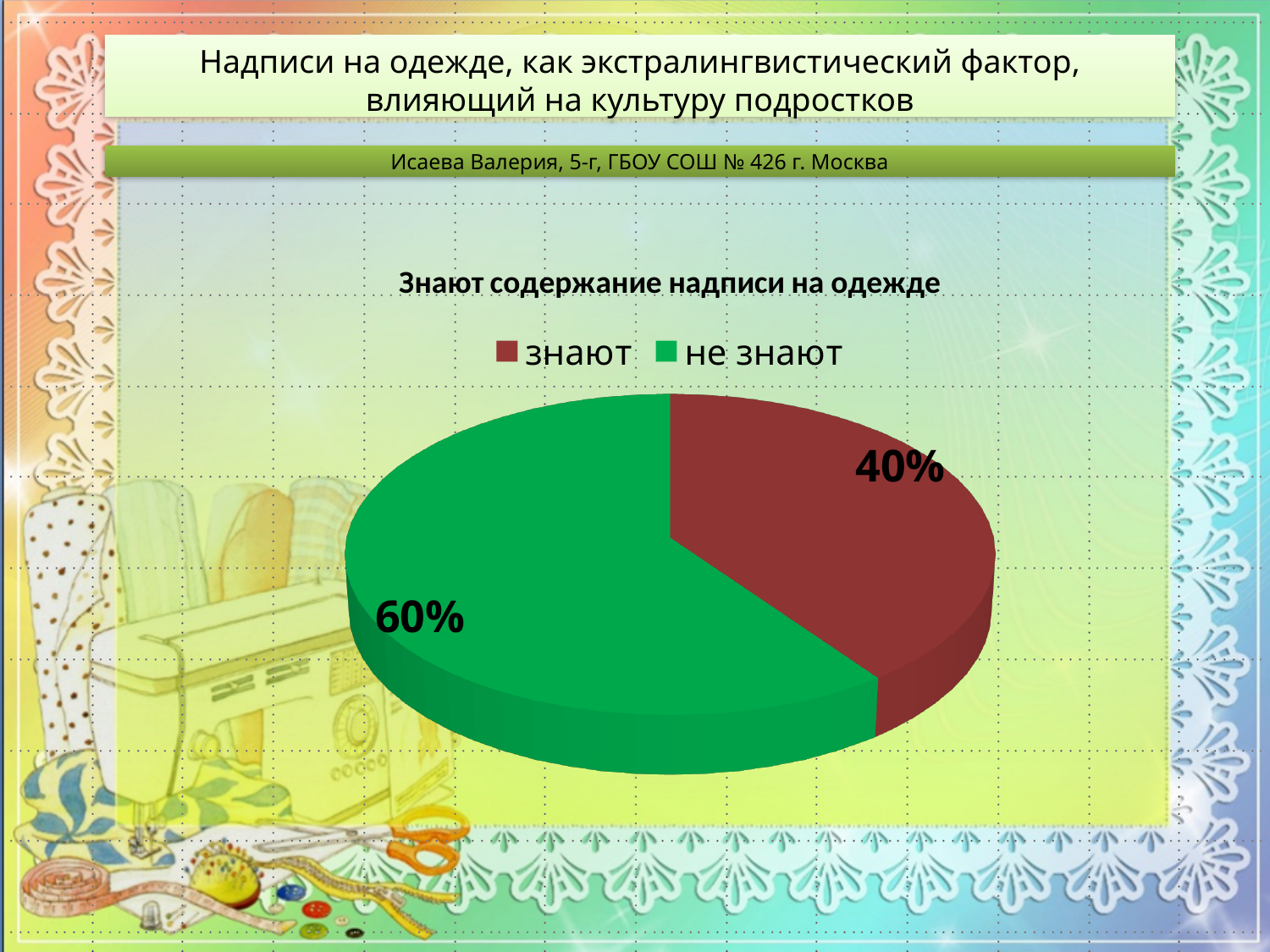
Which is larger: the 'знают' slice or the 'не знают' slice? не знают What is the difference between the 'не знают' share and the 'знают' share? 20% What is the title of the chart? Знают содержание надписи на одежде Which category has the largest slice of the pie? не знают Is the share for 'знают' greater or less than 50%? less What share of the pie does the 'знают' slice represent? 40% Which category has the smallest slice of the pie? знают How many slices does the pie chart have? 2 What type of chart is shown on the slide? pie chart What colour is the 'не знают' slice? green What share of the pie does the 'не знают' slice represent? 60% How many categories does the legend list? 2